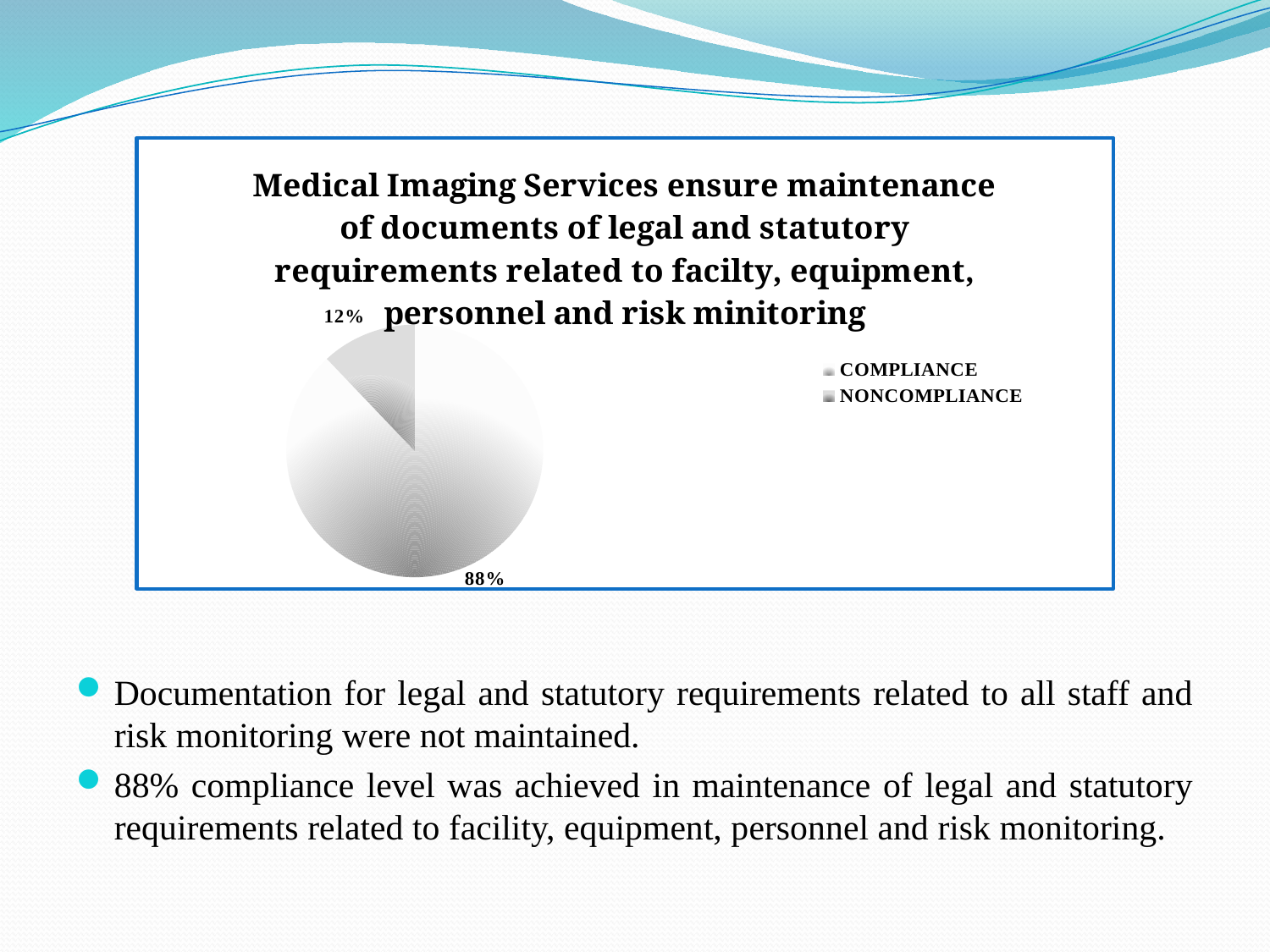
How many entries does the legend of the pie chart list? 2 Which is larger in the pie chart, COMPLIANCE or NONCOMPLIANCE? COMPLIANCE Which slice of the pie chart is the smallest? NONCOMPLIANCE Which slice of the pie chart is the largest? COMPLIANCE What percentage of the pie chart is labelled for COMPLIANCE? 88% What is the total of the two percentages shown on the pie chart? 100% What percentage of the pie chart is labelled for NONCOMPLIANCE? 12% What are the two legend entries of the pie chart? COMPLIANCE and NONCOMPLIANCE How many slices does the pie chart have? 2 What type of chart is shown on the slide? pie chart What is the difference in percentage points between the COMPLIANCE and NONCOMPLIANCE slices? 76 What share of the pie does the COMPLIANCE slice represent? 88%